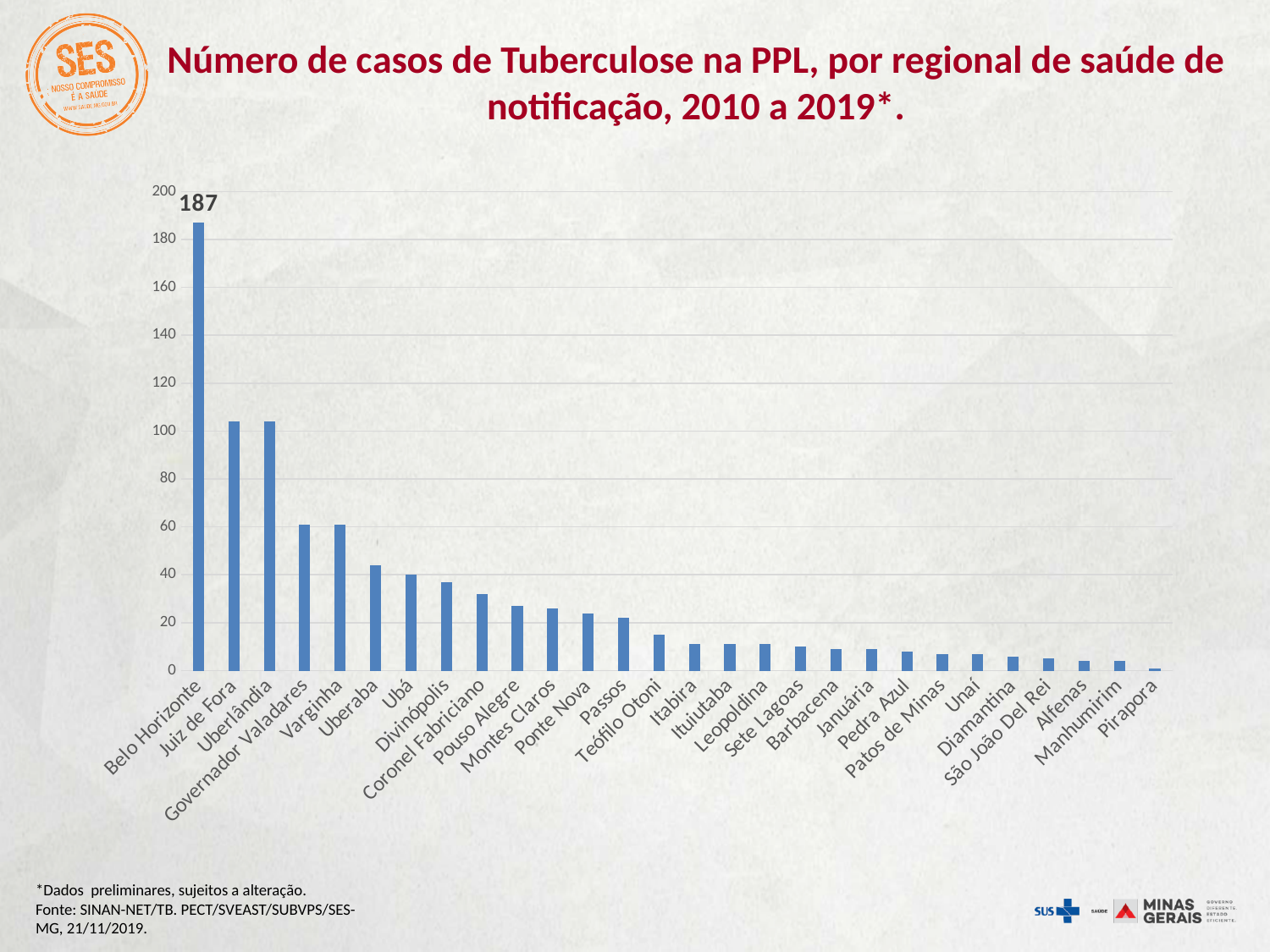
What is the number of tuberculosis cases for Belo Horizonte? 187 Which regional de saúde has the highest number of cases? Belo Horizonte Which has more cases, Belo Horizonte or Juiz de Fora? Belo Horizonte Which regional de saúde has the lowest number of cases? Pirapora Do the values rise or fall moving from left to right along the x axis? fall What period does the chart title say the data covers? 2010 a 2019 How many regionais de saúde are shown on the x axis? 28 Is the value for Teófilo Otoni greater or less than 20? less Is the value for Varginha greater or less than 40? greater What type of chart is shown on the slide? bar chart Is the value for Uberlândia greater or less than 80? greater